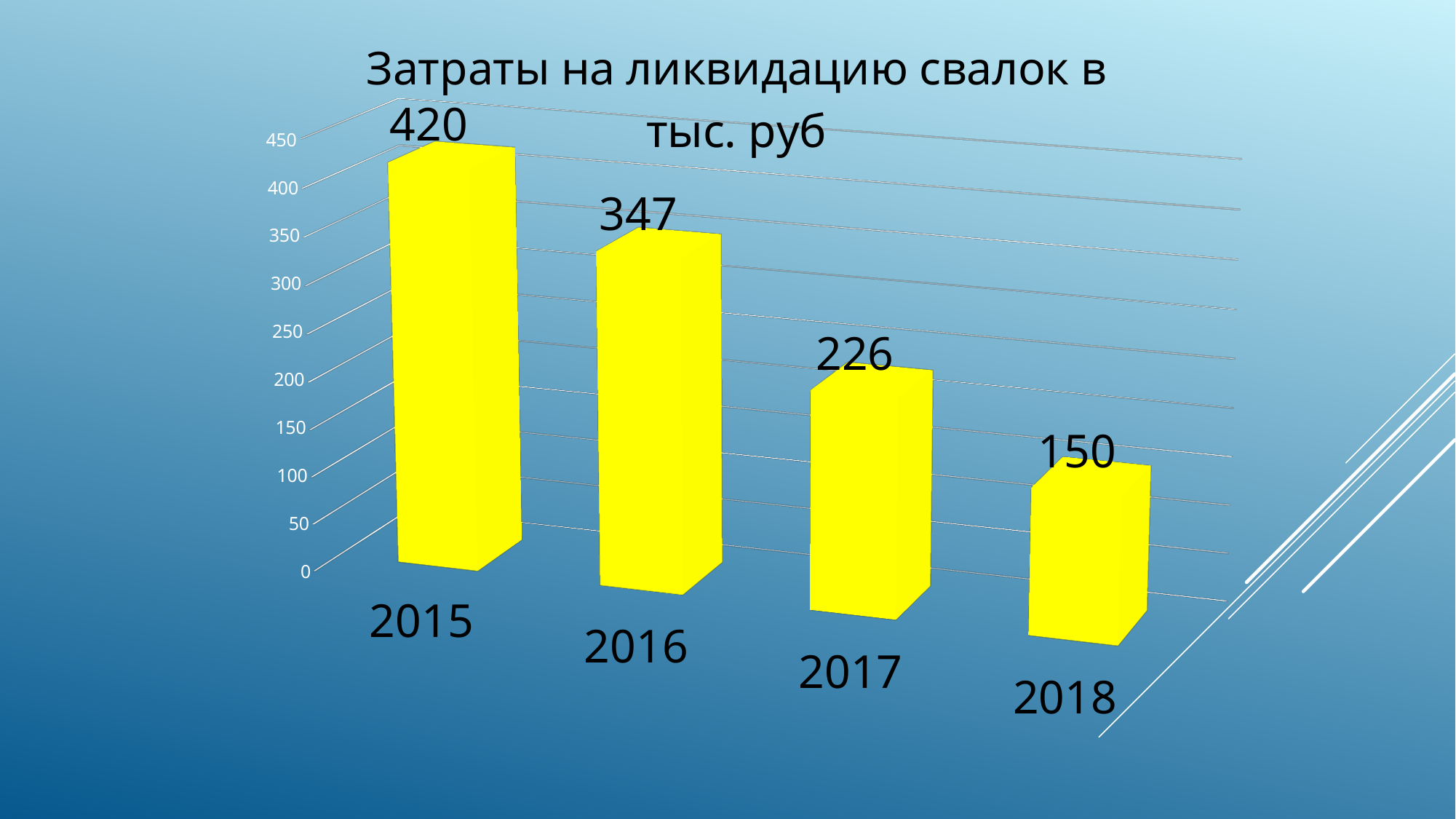
What is the value for 2018? 150 How many years are shown on the chart? 4 What is the value for 2015? 420 Which is larger, the value for 2016 or the value for 2017? 2016 What is the difference between the values for 2015 and 2018? 270 What is the value for 2016? 347 Do the values rise or fall from 2015 to 2018? fall What is the difference between the values for 2016 and 2017? 121 What is the value for 2017? 226 Which year has the highest value? 2015 Which year has the lowest value? 2018 What kind of chart is shown on the slide? bar chart